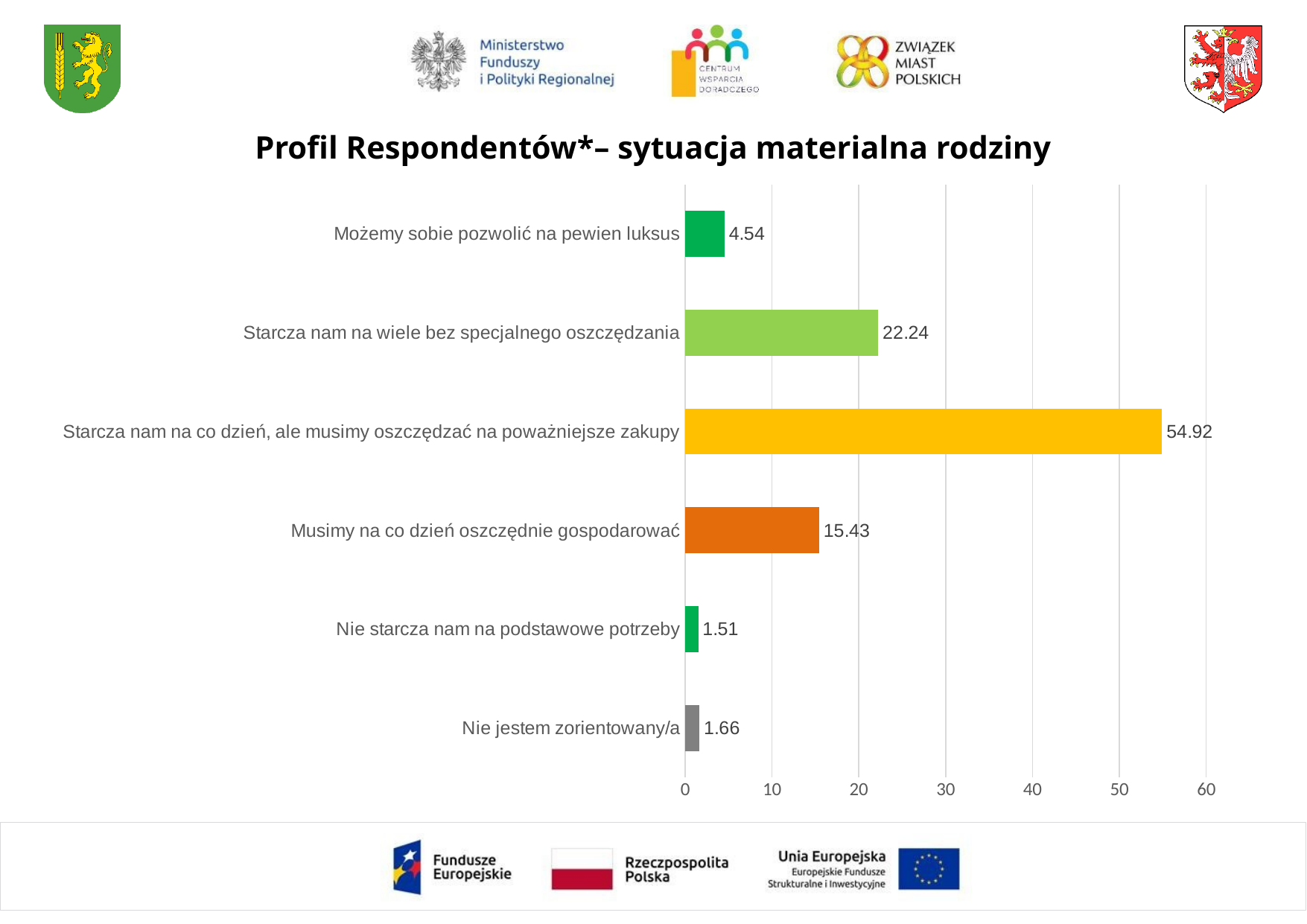
Which is larger: the value for "Starcza nam na wiele bez specjalnego oszczędzania" or for "Musimy na co dzień oszczędnie gospodarować"? Starcza nam na wiele bez specjalnego oszczędzania What is the value for "Możemy sobie pozwolić na pewien luksus"? 4.54 What kind of chart is shown on the slide? bar chart What is the value for "Starcza nam na co dzień, ale musimy oszczędzać na poważniejsze zakupy"? 54.92 Is the value for "Starcza nam na co dzień, ale musimy oszczędzać na poważniejsze zakupy" greater or less than 50? greater How many categories are shown in the chart? 6 What is the difference between the values for "Starcza nam na wiele bez specjalnego oszczędzania" and "Musimy na co dzień oszczędnie gospodarować"? 6.81 What colour is the bar for "Starcza nam na co dzień, ale musimy oszczędzać na poważniejsze zakupy"? yellow Which category has the lowest value? Nie starcza nam na podstawowe potrzeby Which category has the highest value? Starcza nam na co dzień, ale musimy oszczędzać na poważniejsze zakupy What is the title of the chart? Profil Respondentów*– sytuacja materialna rodziny What is the value for "Nie jestem zorientowany/a"? 1.66